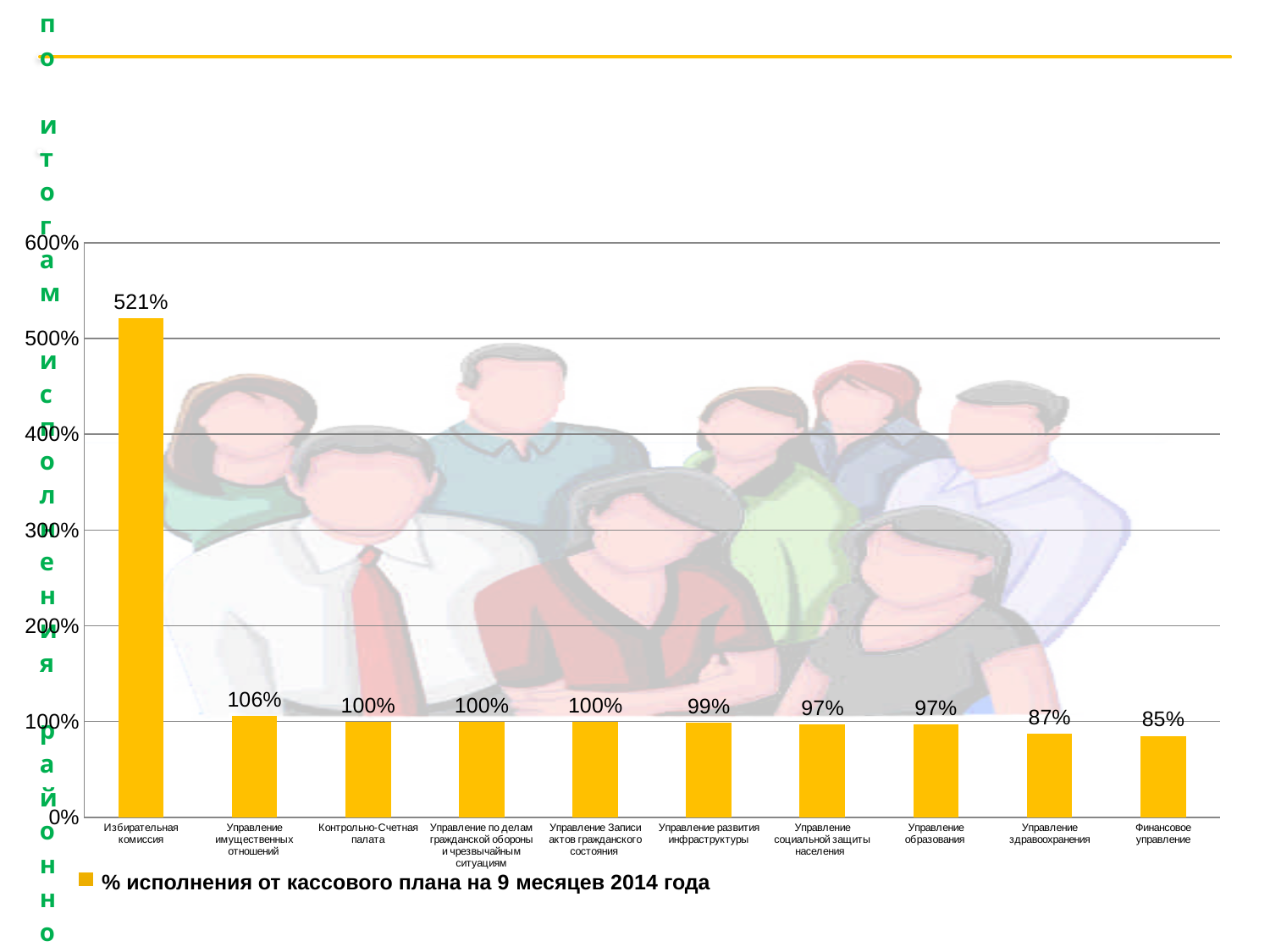
What is the difference between the values for Избирательная комиссия and Управление имущественных отношений? 415% Which is larger, the value for Управление развития инфраструктуры or the value for Управление здравоохранения? Управление развития инфраструктуры Which category has the highest value? Избирательная комиссия What is the value for Управление здравоохранения? 87% What is the value for Финансовое управление? 85% What is the value for Управление имущественных отношений? 106% How many categories are shown on the x axis? 10 Is the value for Избирательная комиссия greater or less than 500%? greater What kind of chart is shown on the slide? bar chart Which category has the lowest value? Финансовое управление What is the value for Избирательная комиссия? 521% What is the legend entry for the series shown? % исполнения от кассового плана на 9 месяцев 2014 года